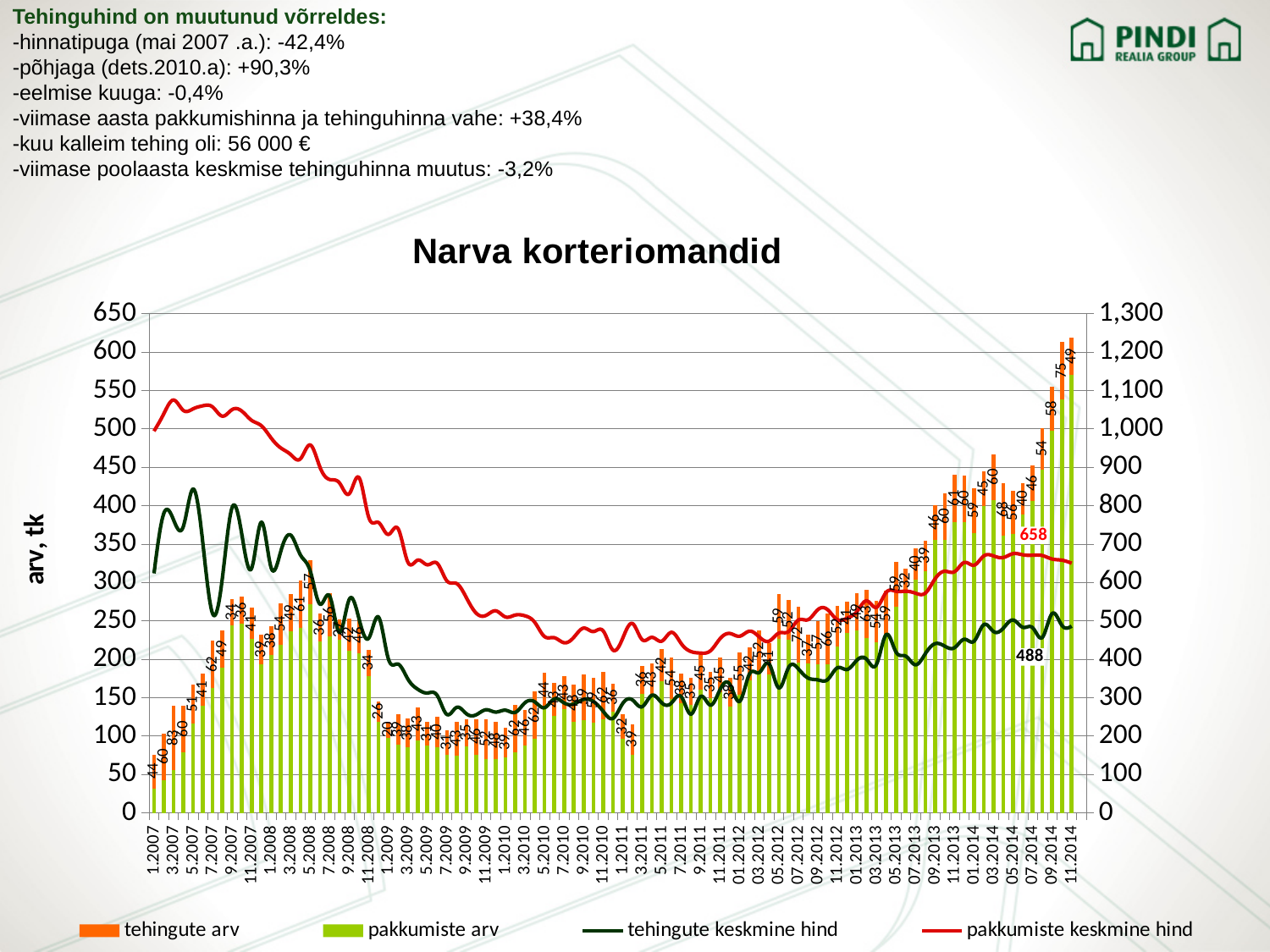
How many series does the chart legend list? 4 Is the pakkumiste arv bar for 11.2014 greater or less than 500 on the left axis? greater What kind of chart is shown on the slide? Combined bar and line chart What is the difference between the labelled end values of pakkumiste keskmine hind (658) and tehingute keskmine hind (488)? 170 What is the labelled tehingute arv value for 1.2007? 44 What is the label of the left vertical axis? arv, tk At the end of the series, which is larger: pakkumiste keskmine hind or tehingute keskmine hind? pakkumiste keskmine hind Does the pakkumiste keskmine hind line rise or fall between 2007 and 2011? fall What is the title of the chart? Narva korteriomandid